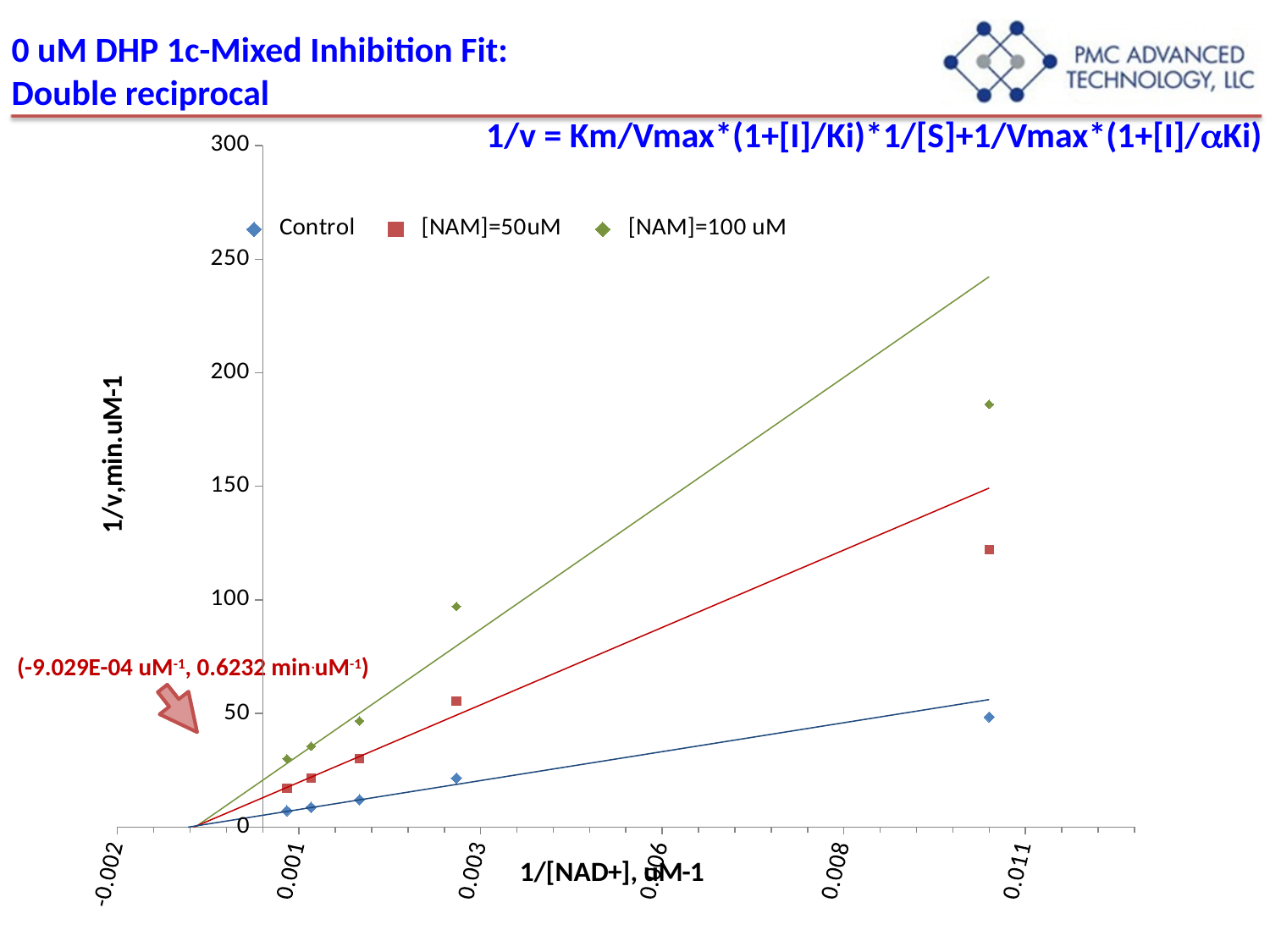
Which series has the highest 1/v value at the rightmost data point (near 0.011 on the x axis)? [NAM]=100 uM Is the 1/v value of the rightmost Control point greater or less than 100? less What is the title of the y axis? 1/v,min.uM-1 What colour are the markers for the [NAM]=100 uM series? Green How many series does the legend list? 3 What kind of chart is shown on the slide? Scatter chart Which series has the lowest 1/v value at the rightmost data point (near 0.011 on the x axis)? Control Is the 1/v value of the rightmost [NAM]=100 uM point greater or less than 150? greater Is the 1/v value of the rightmost [NAM]=50uM point greater or less than 100? greater Do the 1/v values for the [NAM]=100 uM series rise or fall as 1/[NAD+] increases? Rise How many data points are plotted for the Control series? 5 At the rightmost data point, is the 1/v value larger for [NAM]=50uM or for Control? [NAM]=50uM